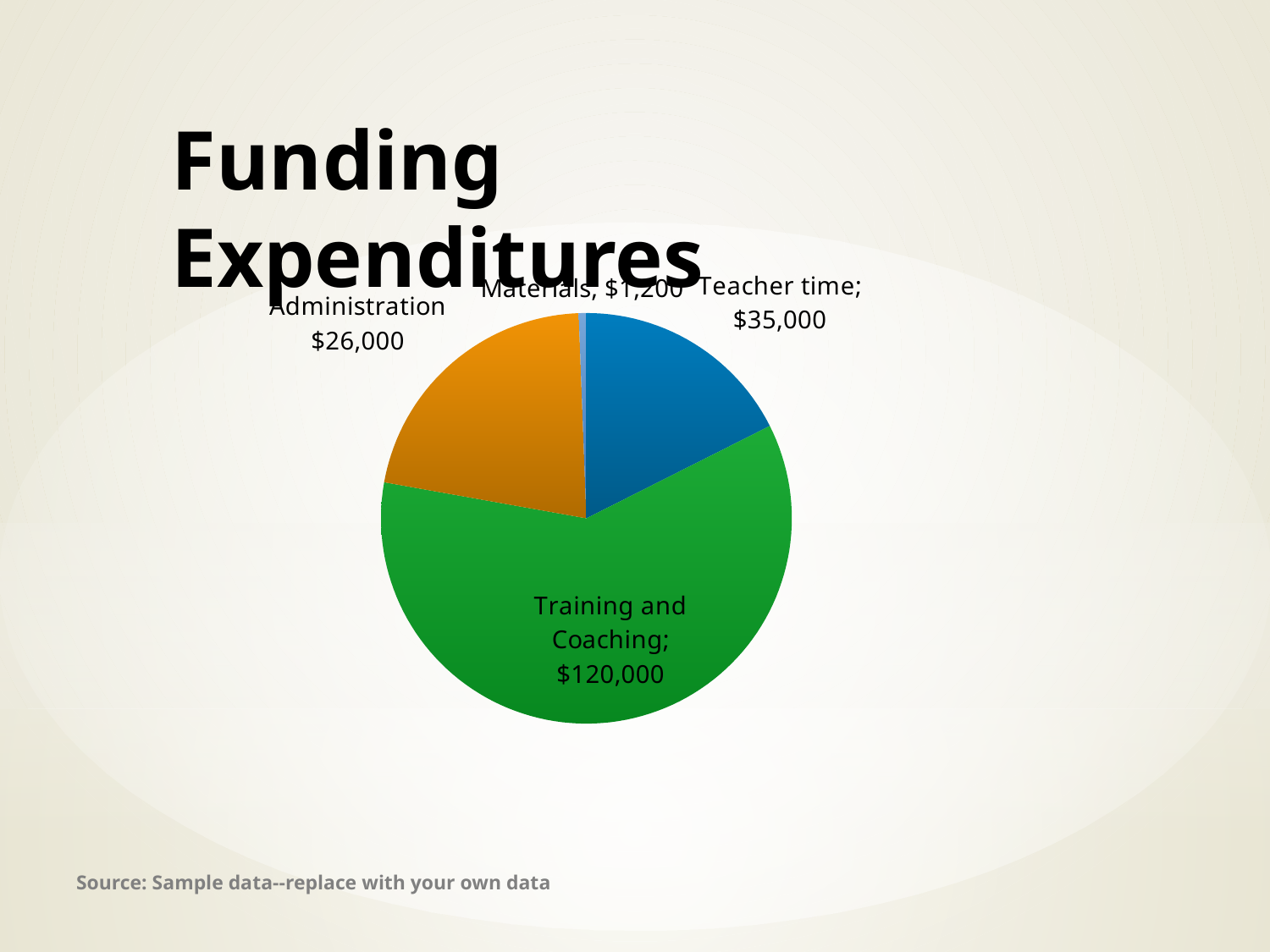
What is the value for Administration? $26,000 Which category has the smallest expenditure? Materials Which category has the largest expenditure? Training and Coaching What is the total of all four expenditure categories? $182,200 What is the difference between Training and Coaching and Teacher time? $85,000 What is the value for Training and Coaching? $120,000 What type of chart is shown on the slide? Pie chart What is the value for Teacher time? $35,000 How many slices does the pie chart have? 4 What is the title of the chart? Funding Expenditures What is the value for Materials? $1,200